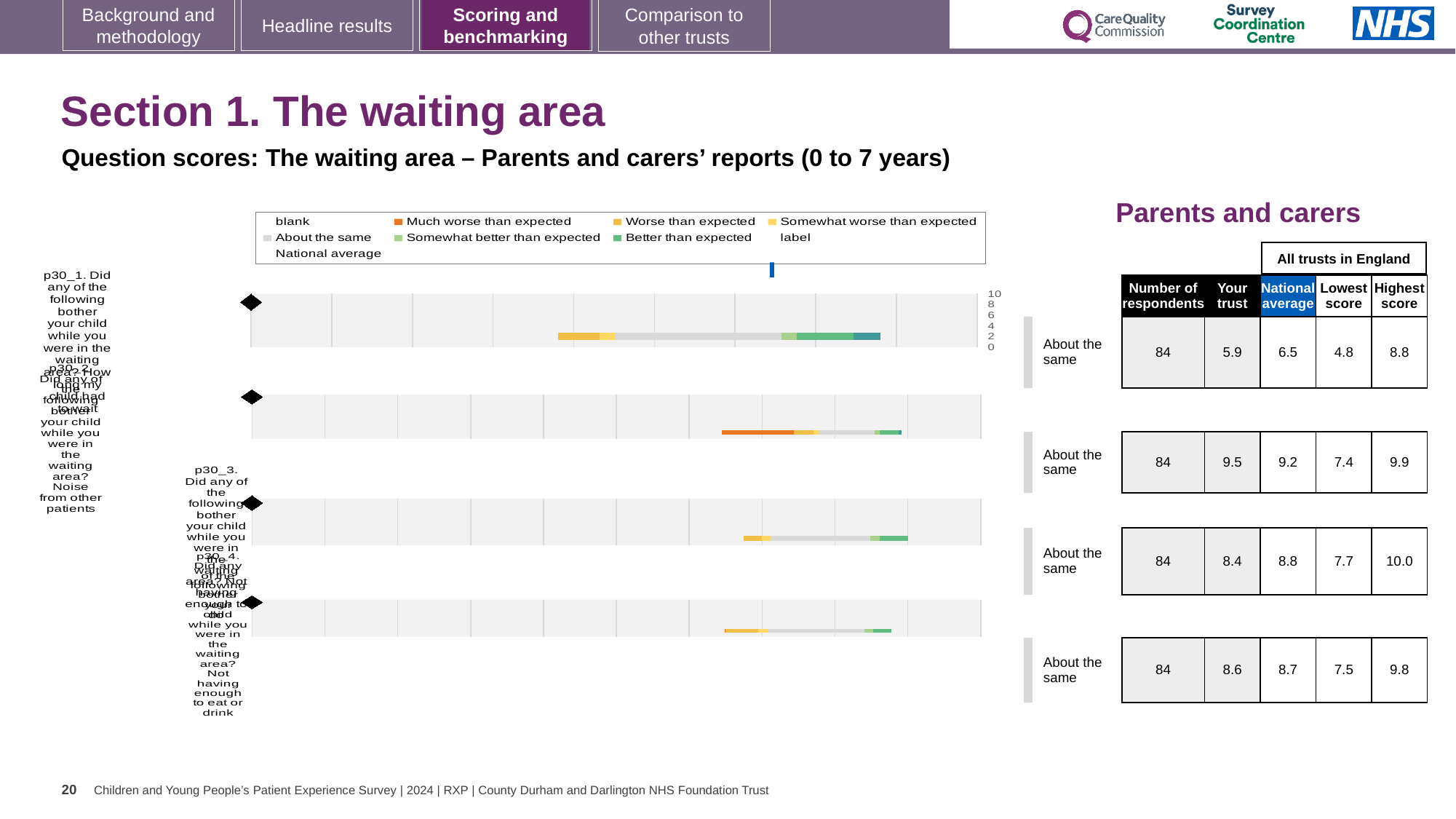
What is the highest score across all trusts in England for p30_3 (Not having enough to do)? 10.0 How many questions (bars) are plotted in the chart? 4 What kind of chart is shown on the slide? bar chart What is the national average score for p30_1 (Noise from other patients)? 6.5 Which question has the lowest 'Your trust' score? p30_1 (Noise from other patients) What is the 'Your trust' score for p30_2 (How long my child had to wait)? 9.5 For p30_2, is the 'Your trust' score or the national average larger? Your trust How many respondents answered p30_1? 84 What is the benchmark rating shown next to the first bar (p30_1)? About the same Which question has the highest 'Your trust' score? p30_2 (How long my child had to wait) What is the lowest score across all trusts in England for p30_4 (Not having enough to eat or drink)? 7.5 Which colour does the legend use for 'Much worse than expected'? orange